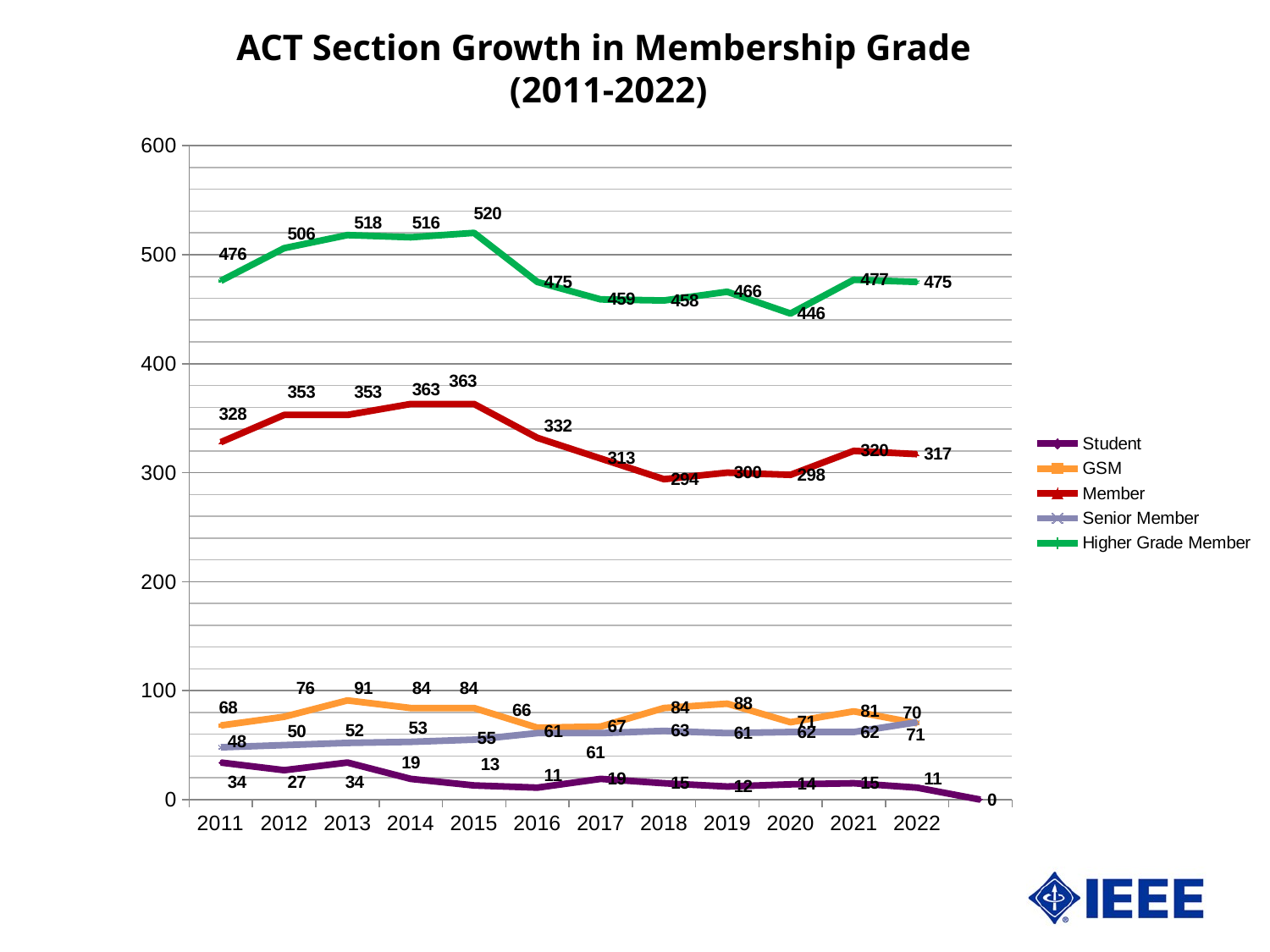
How many years are labelled on the x axis? 12 What is the Higher Grade Member value in 2015? 520 Does the Senior Member line rise or fall from 2011 to 2015? rise What is the GSM value in 2013? 91 How many series does the legend list? 5 In which year is the Higher Grade Member value highest? 2015 What is the Student value in 2011? 34 Is the Member value in 2018 greater or less than 300? less What colour is the Higher Grade Member line? green In which year is the Member value lowest? 2018 What is the difference between the Member value in 2015 and in 2011? 35 What kind of chart is shown on the slide? line chart